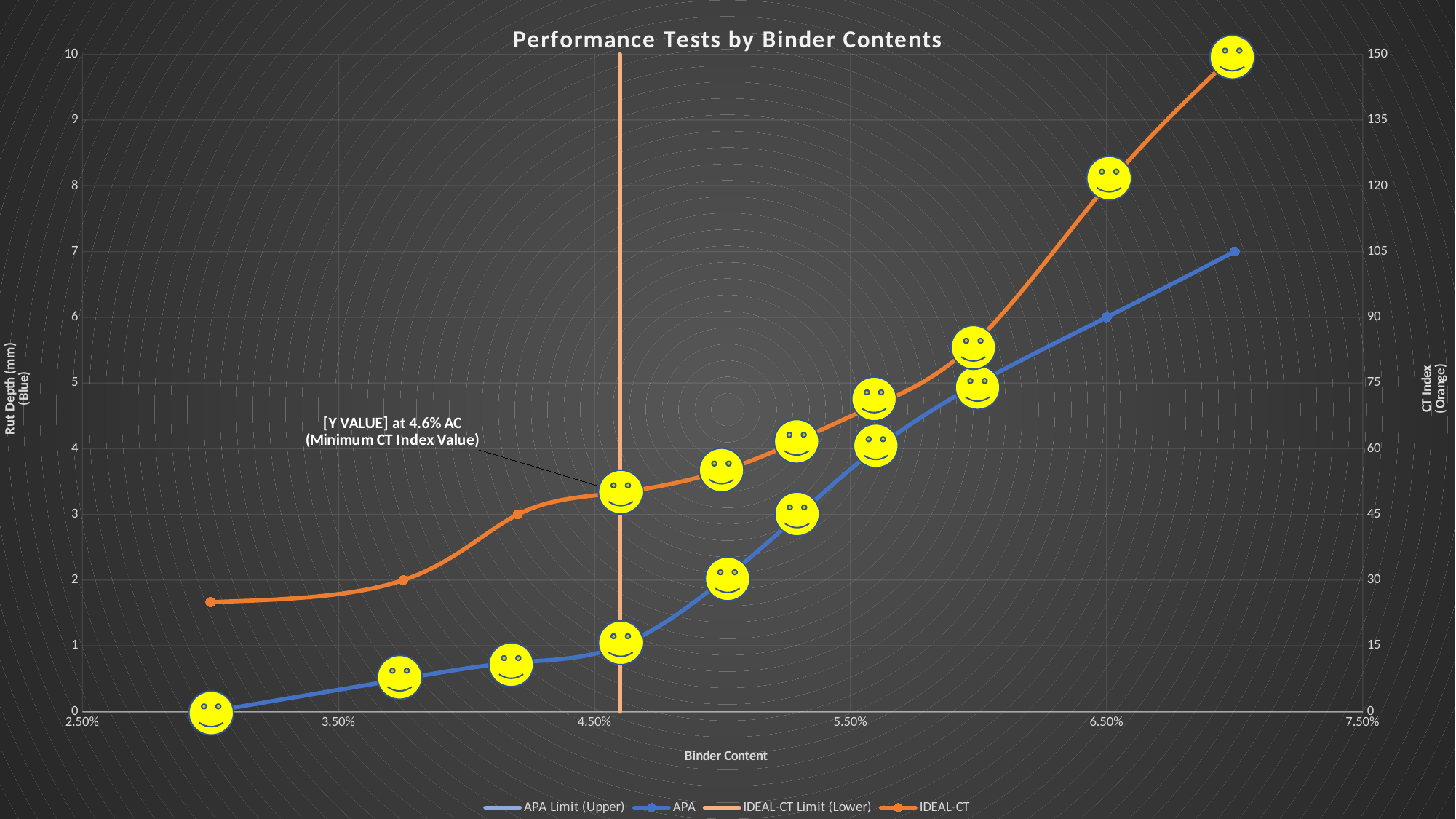
Is the leftmost IDEAL-CT data point greater or less than 45? less What is the title of the chart? Performance Tests by Binder Contents How many series does the legend list? 4 Is the IDEAL-CT value at 6.50% binder content greater or less than 105? greater Does the IDEAL-CT series rise or fall as binder content increases? rises How many data points are plotted for the APA series? 10 What kind of chart is shown on the slide? line chart Is the rightmost APA data point greater or less than 5 mm? greater Does the APA series rise or fall as binder content increases? rises At what binder content does the annotation mark the minimum CT index value? 4.6% AC